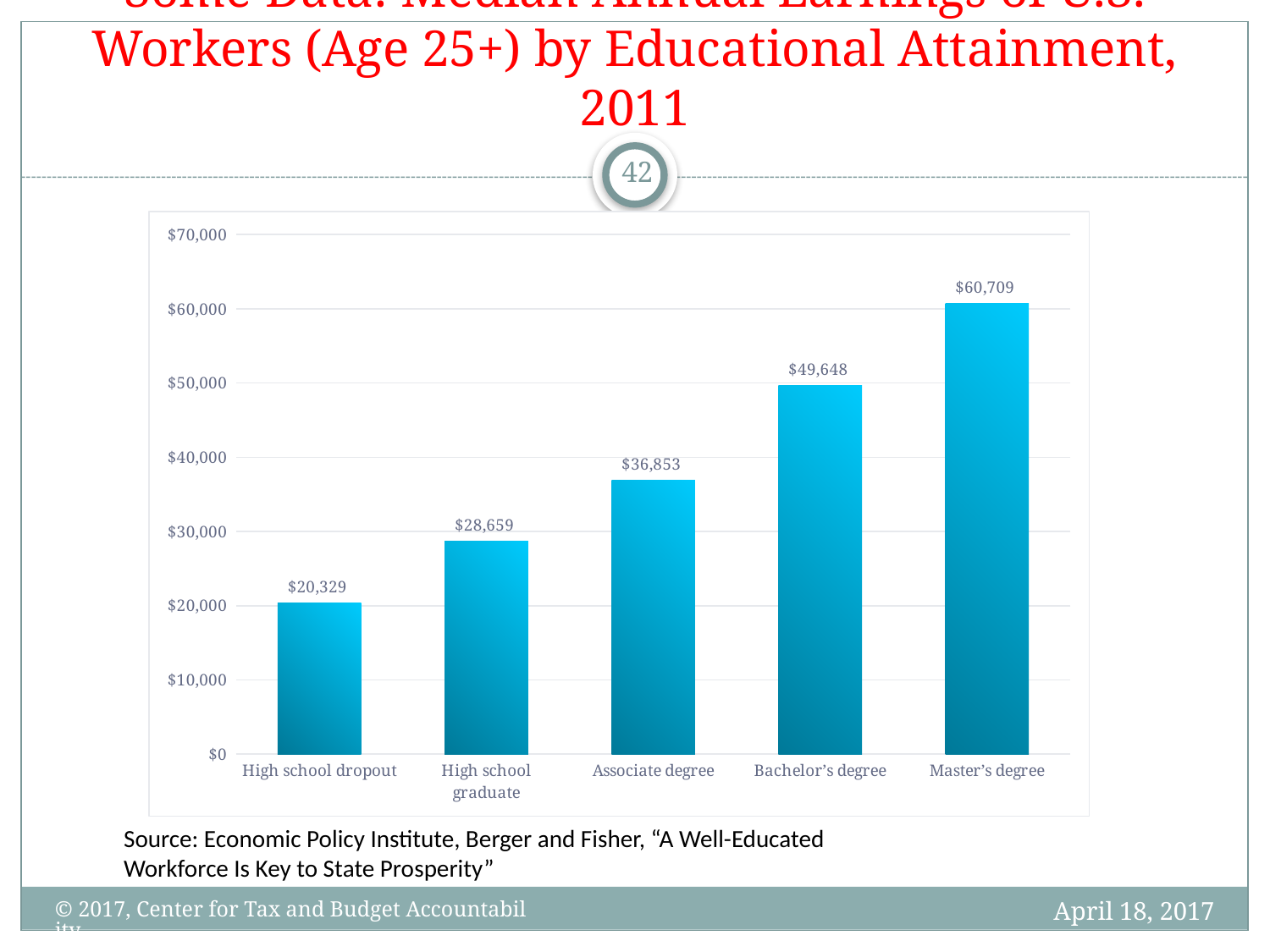
Which is larger, the value for Associate degree or the value for High school graduate? Associate degree Is the value for Bachelor's degree greater or less than $50,000? less Which educational attainment category has the highest median annual earnings? Master's degree What is the value shown for Bachelor's degree? $49,648 Which educational attainment category has the lowest median annual earnings? High school dropout How many educational attainment categories are shown on the chart? 5 What is the difference between the values for High school graduate and High school dropout? $8,330 What is the value shown for Associate degree? $36,853 What kind of chart is shown on the slide? bar chart What is the difference between the values for Master's degree and Bachelor's degree? $11,061 Do the values rise or fall moving from High school dropout to Master's degree along the x axis? rise What is the median annual earnings value for High school dropout? $20,329